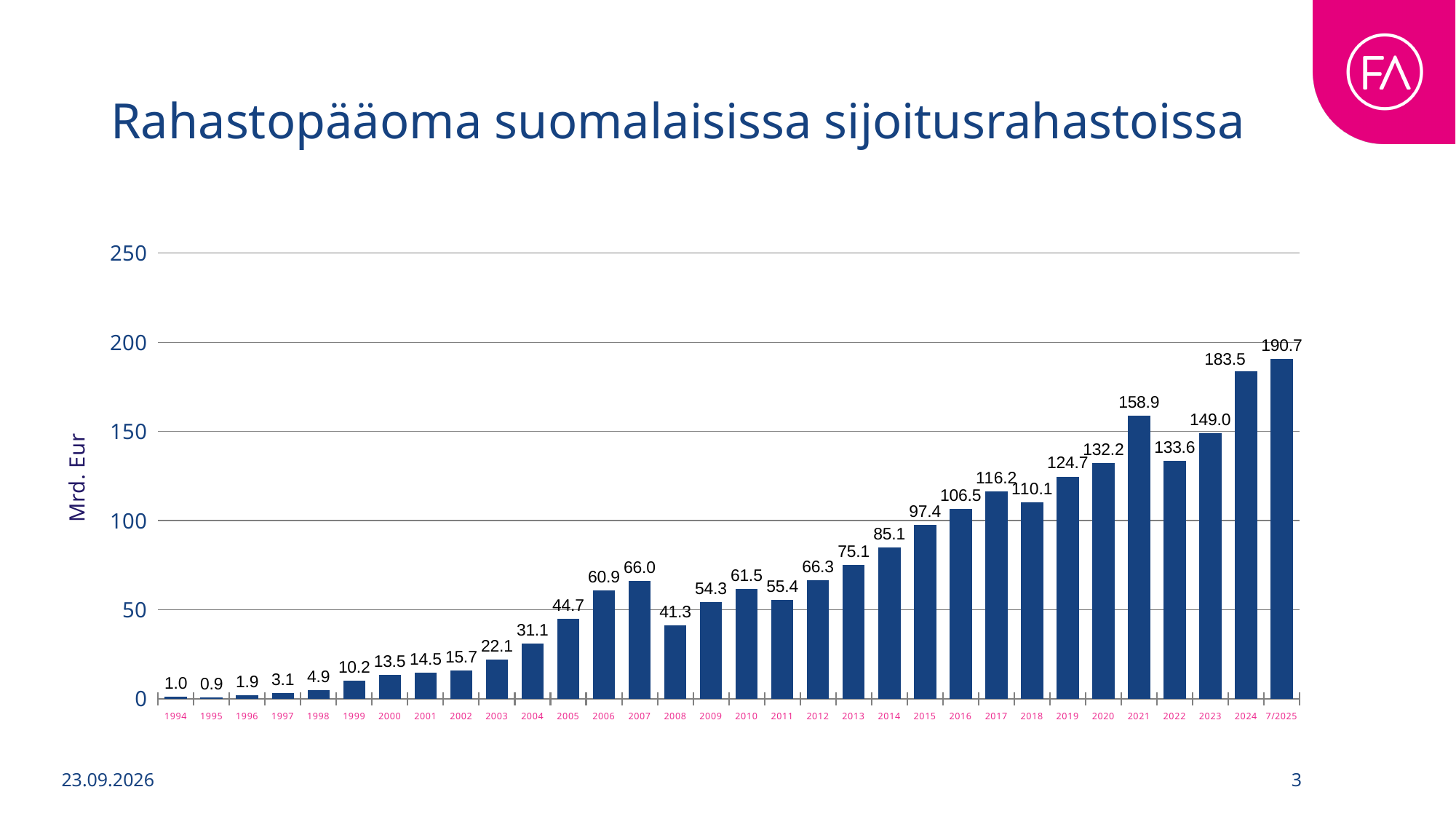
What is the value for 2008? 41.3 Which year has the lowest value? 1995 What is the difference between the values for 2021 and 2022? 25.3 Is the value for 2021 greater or less than 150? greater What is the value for 7/2025? 190.7 What is the difference between the values for 7/2025 and 2024? 7.2 Which is larger, the value for 2007 or the value for 2008? 2007 What kind of chart is shown on the slide? bar chart How many bars are shown in the chart? 32 Which category has the highest value? 7/2025 What is the value for 2015? 97.4 What is the label on the vertical axis? Mrd. Eur